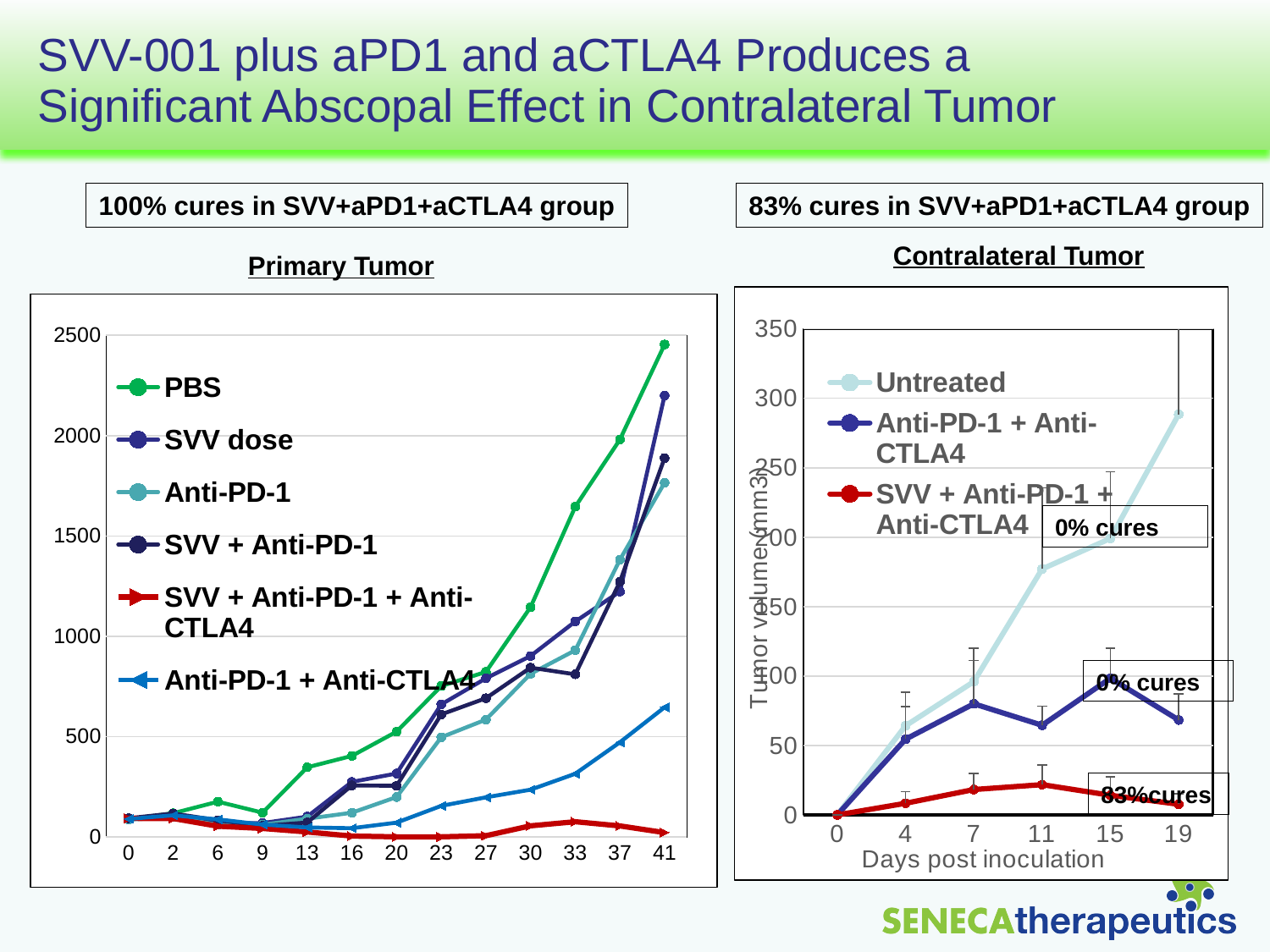
What is the x-axis label of the Contralateral Tumor chart? Days post inoculation On the Primary Tumor chart, which series has the highest value at day 41? PBS On the Contralateral Tumor chart, is the SVV + Anti-PD-1 + Anti-CTLA4 value at day 19 greater or less than 50? less How many series does the legend of the Contralateral Tumor chart list? 3 On the Primary Tumor chart, is the Anti-PD-1 + Anti-CTLA4 value at day 41 greater or less than 1000? less On the Primary Tumor chart, which series has the lowest value at day 41? SVV + Anti-PD-1 + Anti-CTLA4 How many series does the legend of the Primary Tumor chart list? 6 How many x-axis time points are plotted on the Primary Tumor chart? 13 On the Primary Tumor chart, is the PBS value at day 41 greater or less than 2000? greater On the Contralateral Tumor chart, which series has the highest value at day 19? Untreated What type of chart is the Primary Tumor chart? line chart On the Primary Tumor chart, does the PBS series rise or fall from day 13 to day 41? rise